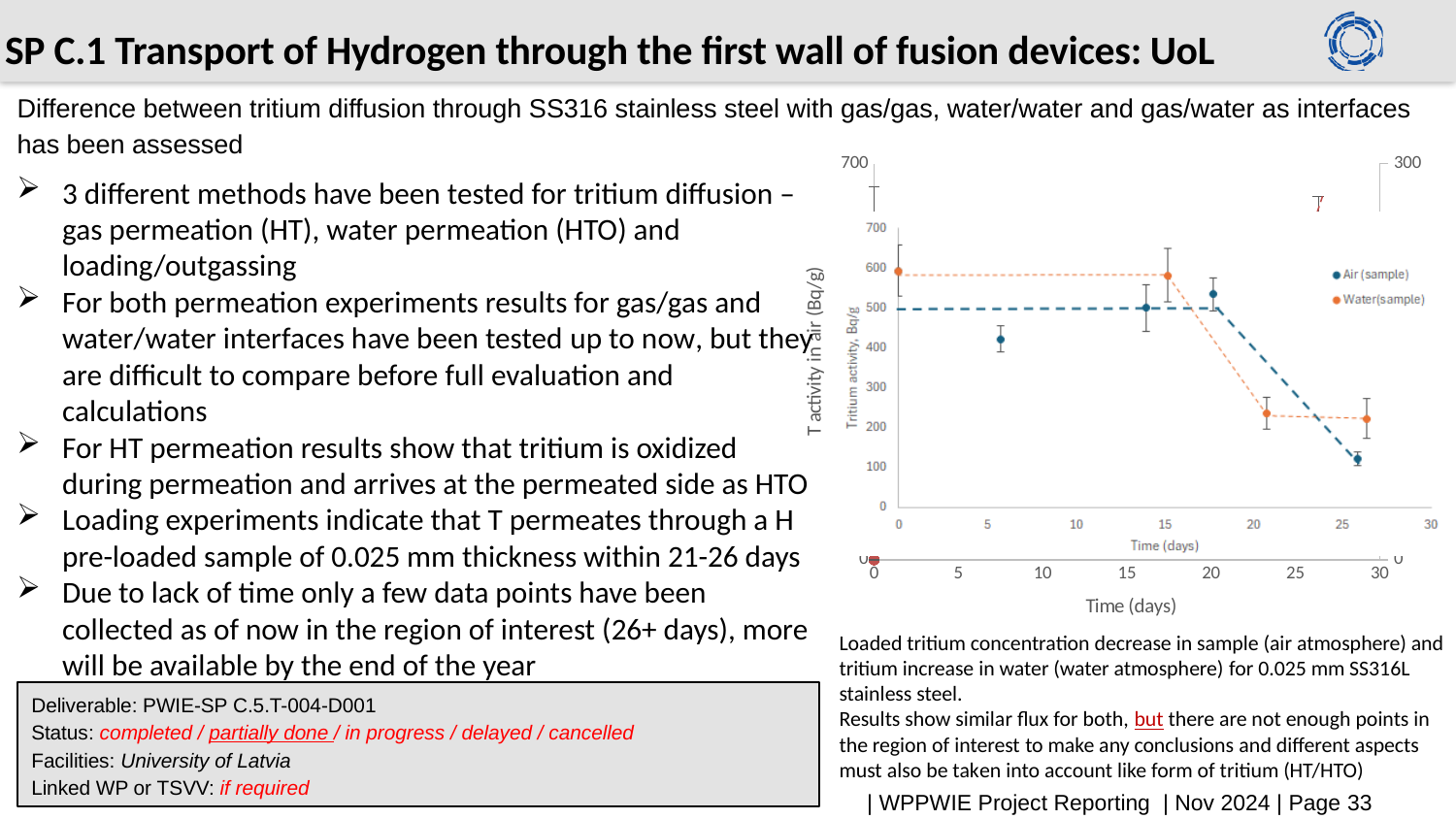
Do the Air (sample) values rise or fall overall as time increases along the x axis? fall What are the two series named in the chart legend? Air (sample) and Water(sample) What is the label of the x axis of the chart? Time (days) Is the Water(sample) value at the last time point (around 26 days) greater or less than 300? less How many series does the chart legend list? 2 What kind of chart is shown on the slide? scatter chart Do the Water(sample) values rise or fall overall as time increases along the x axis? fall At the last time point (around 26 days), which series has the higher value, Air (sample) or Water(sample)? Water(sample) Is the Water(sample) value at 0 days greater or less than 500? greater Is the Air (sample) value at the last time point (around 26 days) greater or less than 200? less How many data points are plotted for the Air (sample) series? 5